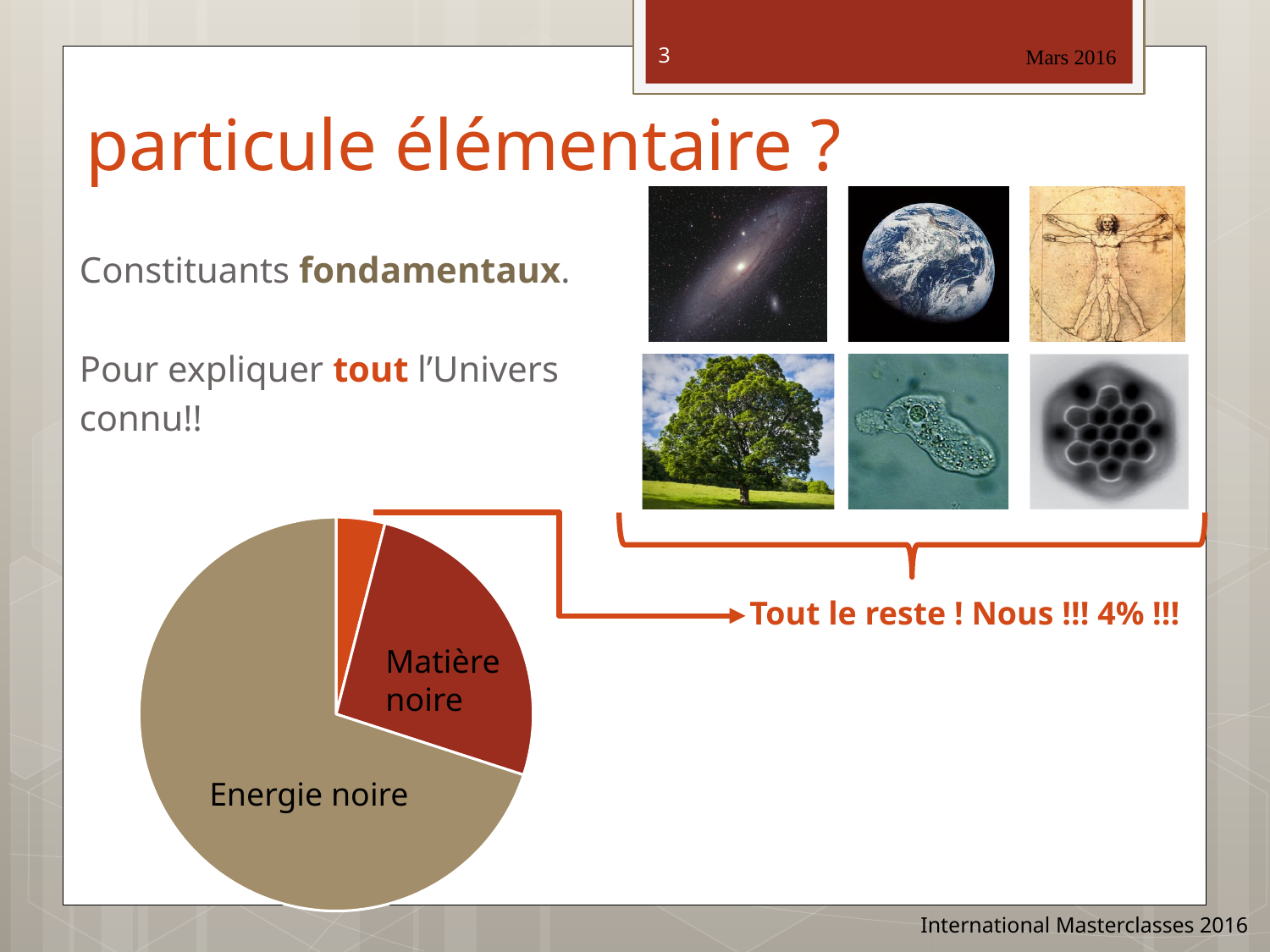
Is the share of the small orange slice ('Tout le reste') greater or less than 50%? less What is the label of the red slice in the pie chart? Matière noire Which slice of the pie chart is the largest? Energie noire How many slices does the pie chart have? 3 What share of the pie does the small orange slice labelled 'Tout le reste ! Nous' represent? 4% What colour is the Energie noire slice in the pie chart? tan (beige-brown) Is the Energie noire slice greater or less than half of the pie? greater Which slice of the pie chart is the smallest? Tout le reste (Nous) What kind of chart is shown on the slide? pie chart Which is larger in the pie chart, Energie noire or Matière noire? Energie noire